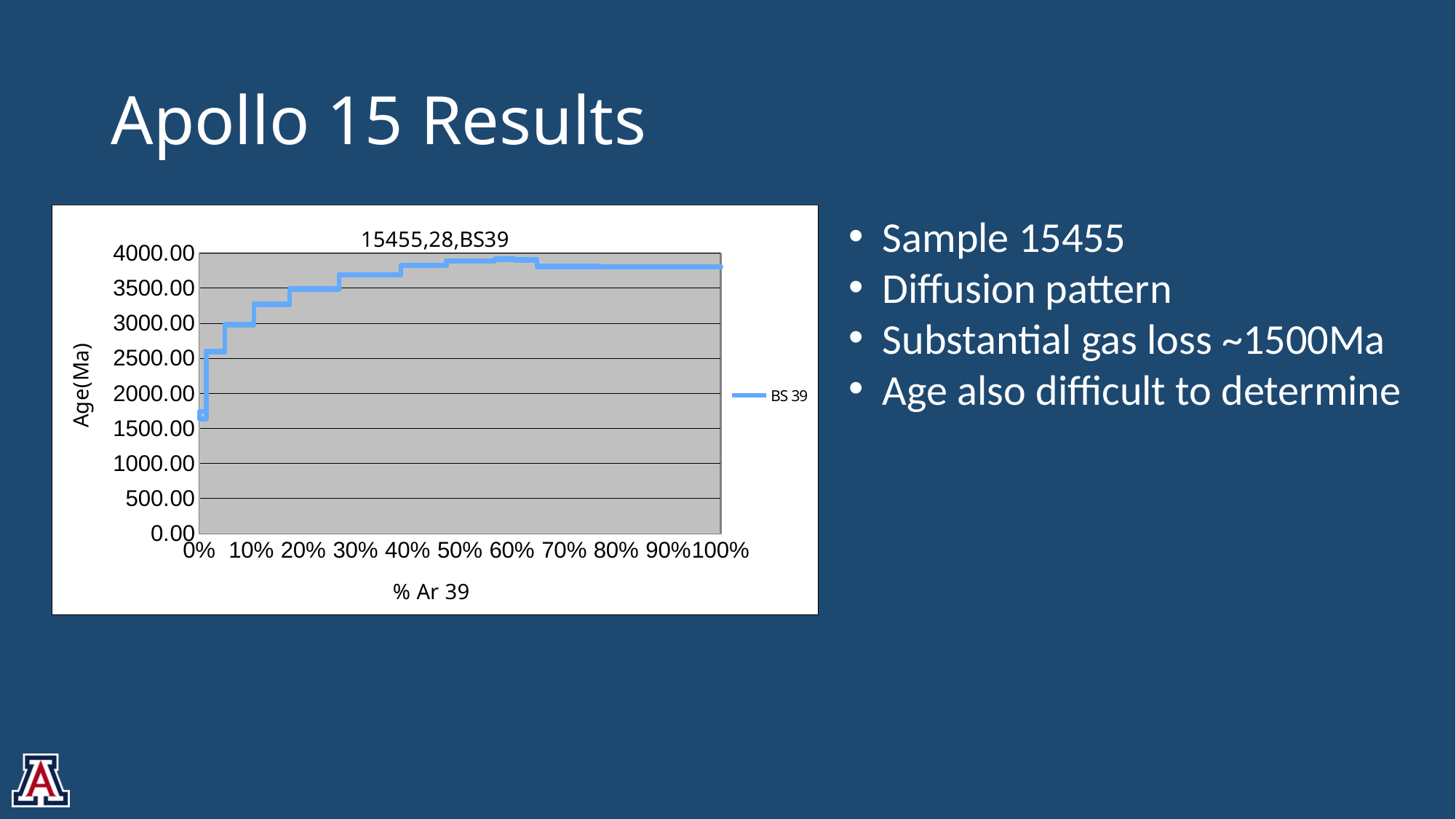
Is the value of the BS 39 line at 30% Ar 39 greater or less than 3000? greater Is the lowest value of the BS 39 line greater or less than 2000? less Is the value of the BS 39 line at 100% Ar 39 greater or less than 3500? greater What is the title of the chart? 15455,28,BS39 Is the value of the BS 39 line at 50% Ar 39 greater or less than 3500? greater What is the name of the series shown in the chart legend? BS 39 Is the highest value of the BS 39 line greater or less than 3500? greater What kind of chart is shown on the slide? line chart Which is larger, the value of the BS 39 line at 0% Ar 39 or at 60% Ar 39? 60% Ar 39 Between 0% and 50% Ar 39, does the BS 39 line rise or fall? rise How many series does the chart legend list? 1